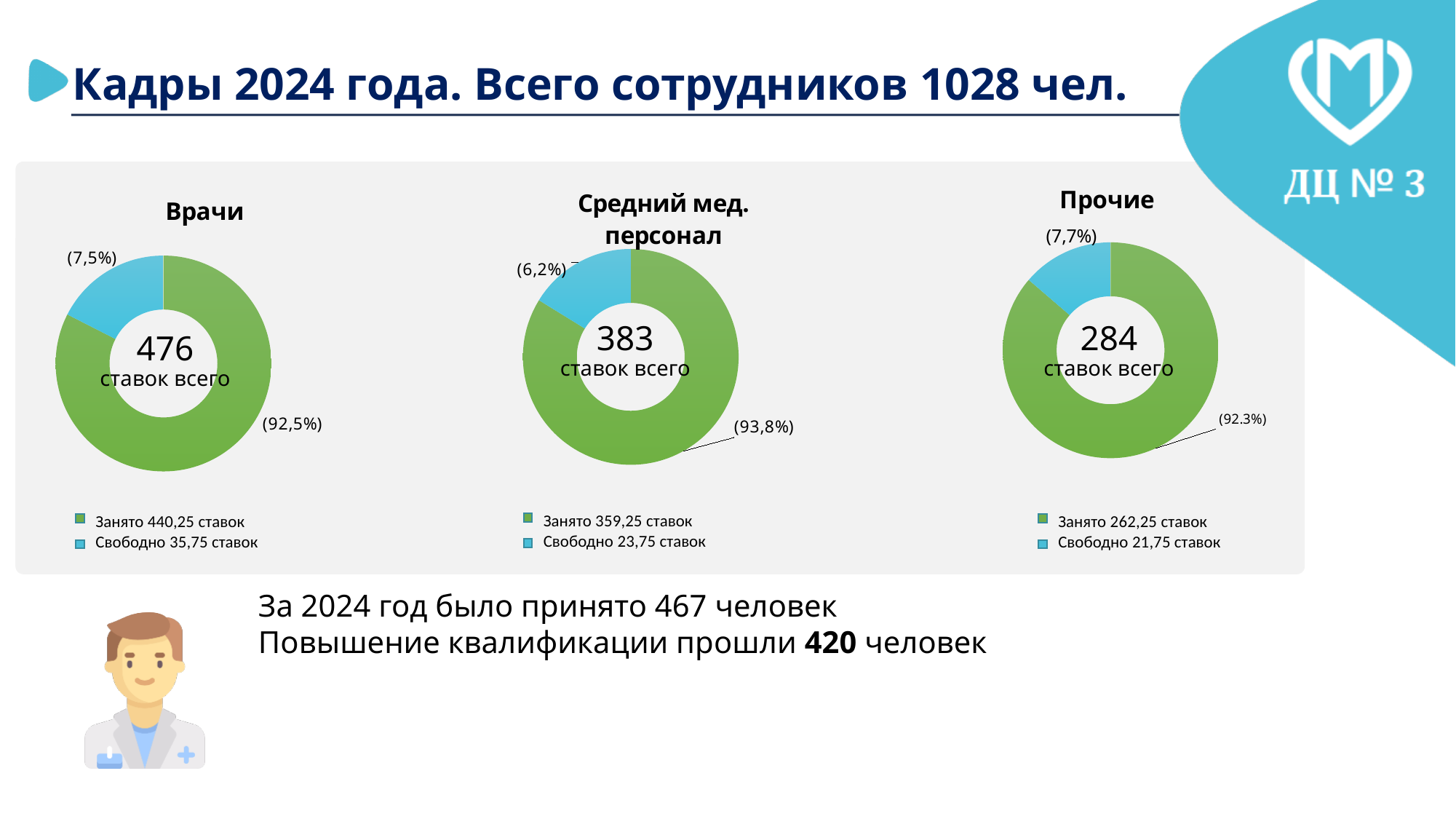
In the "Врачи" chart, which segment is larger, Занято or Свободно? Занято What is the total number of ставок shown in the centre of the "Средний мед. персонал" chart? 383 ставок всего In the "Врачи" chart, how many ставок are занято? 440,25 ставок What type of chart is used for "Врачи"? Donut (pie) chart In the "Прочие" chart, how many ставок are свободно? 21,75 ставок In the "Средний мед. персонал" chart, how many ставок are занято? 359,25 ставок In the "Врачи" chart, what share of the total is занято? 92,5% In the "Средний мед. персонал" chart, what share of the total is свободно? 6,2% In the "Врачи" chart, how many ставок are свободно? 35,75 ставок In the "Прочие" chart, what share of the total is занято? 92.3% How many entries does the legend of the "Прочие" chart list? 2 What is the total number of ставок shown in the centre of the "Прочие" chart? 284 ставок всего